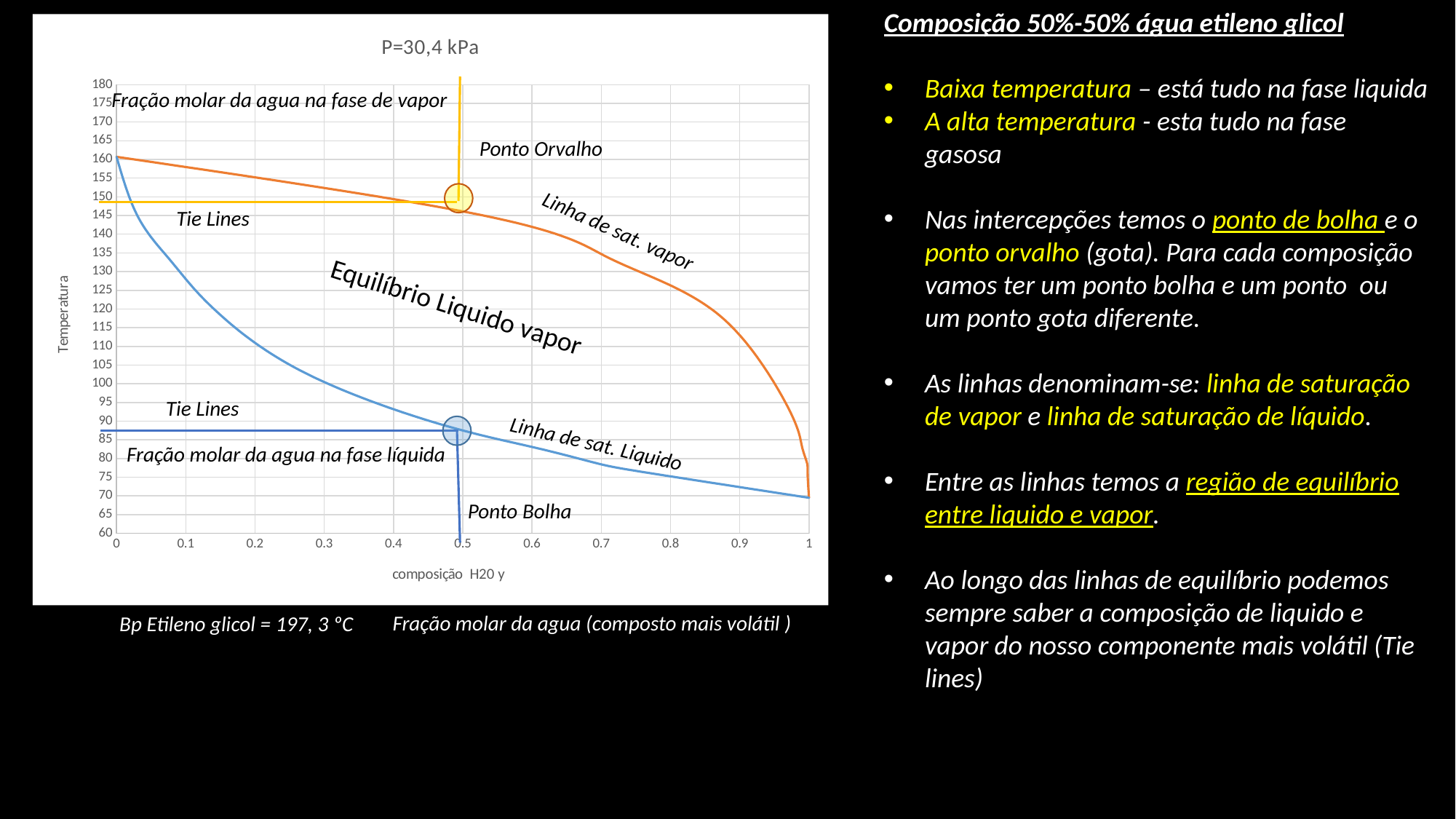
What is the label of the x axis of the chart? composição H20 y What is the title of the chart? P=30,4 kPa At composition 0.5, which curve shows the higher temperature, 'Linha de sat. vapor' or 'Linha de sat. Liquido'? Linha de sat. vapor At composition 0.5, is the temperature on the 'Linha de sat. Liquido' greater or less than 100? less As the composition increases from 0 to 1, does the temperature on the 'Linha de sat. Liquido' rise or fall? fall How many curves are plotted on the chart? 2 What kind of chart is shown on the slide? line chart At composition 0.2, is the temperature on the 'Linha de sat. Liquido' greater or less than 130? less As the composition increases from 0 to 1, does the temperature on the 'Linha de sat. vapor' rise or fall? fall At composition 0.5, is the temperature on the 'Linha de sat. vapor' greater or less than 140? greater